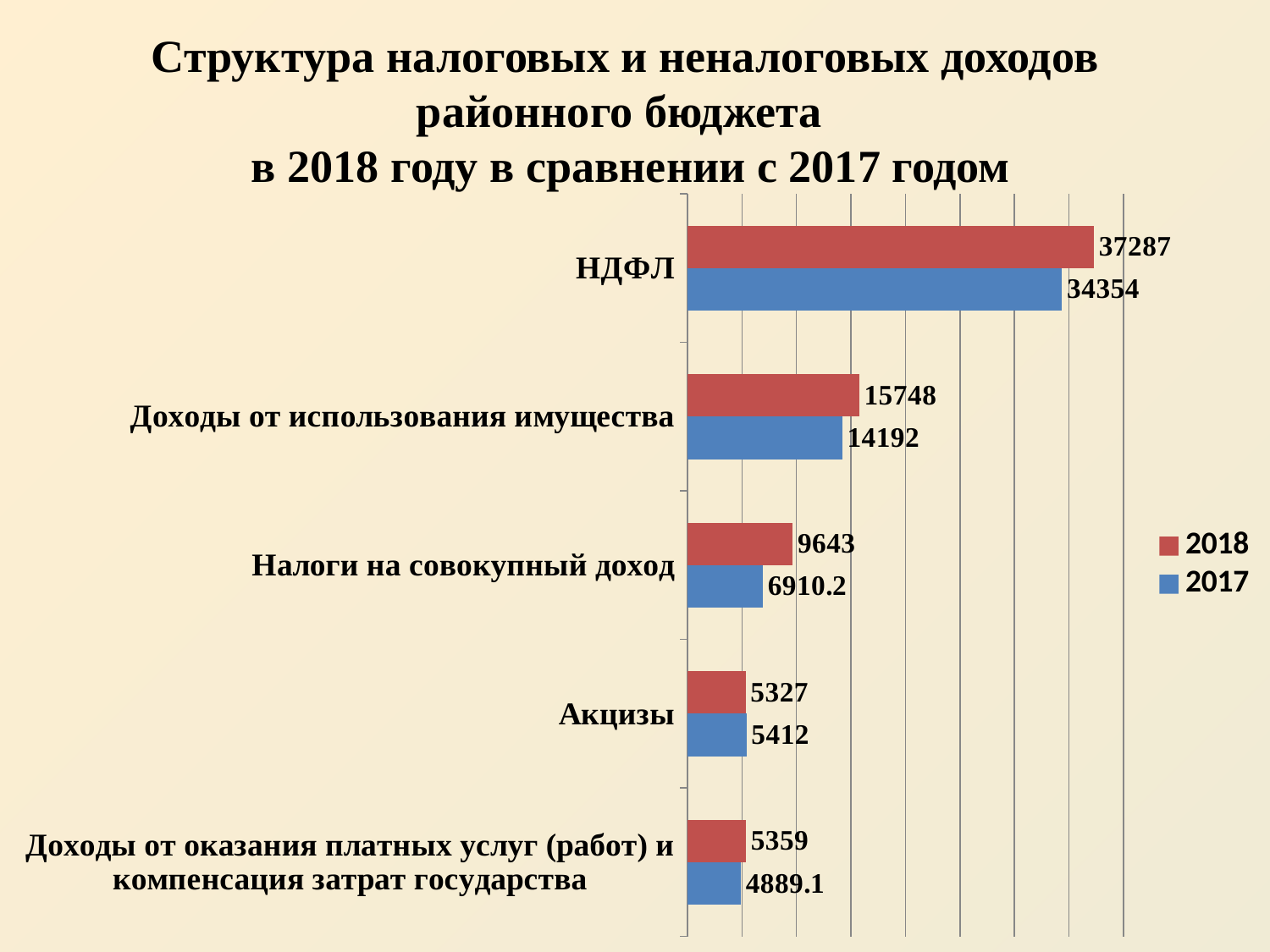
What is the difference between the 2017 and 2018 values for Акцизы? 85 What is the 2017 value for Доходы от оказания платных услуг (работ) и компенсация затрат государства? 4889.1 What is the difference between the 2018 and 2017 values for НДФЛ? 2933 What is the 2018 value for Доходы от использования имущества? 15748 What is the 2018 value for НДФЛ? 37287 How many series does the legend list? 2 What kind of chart is shown on the slide? Bar chart Which category has the highest 2018 value? НДФЛ Which category has the lowest 2017 value? Доходы от оказания платных услуг (работ) и компенсация затрат государства For Акцизы, which year has the larger value, 2018 or 2017? 2017 What is the 2017 value for Налоги на совокупный доход? 6910.2 How many categories are shown in the chart? 5